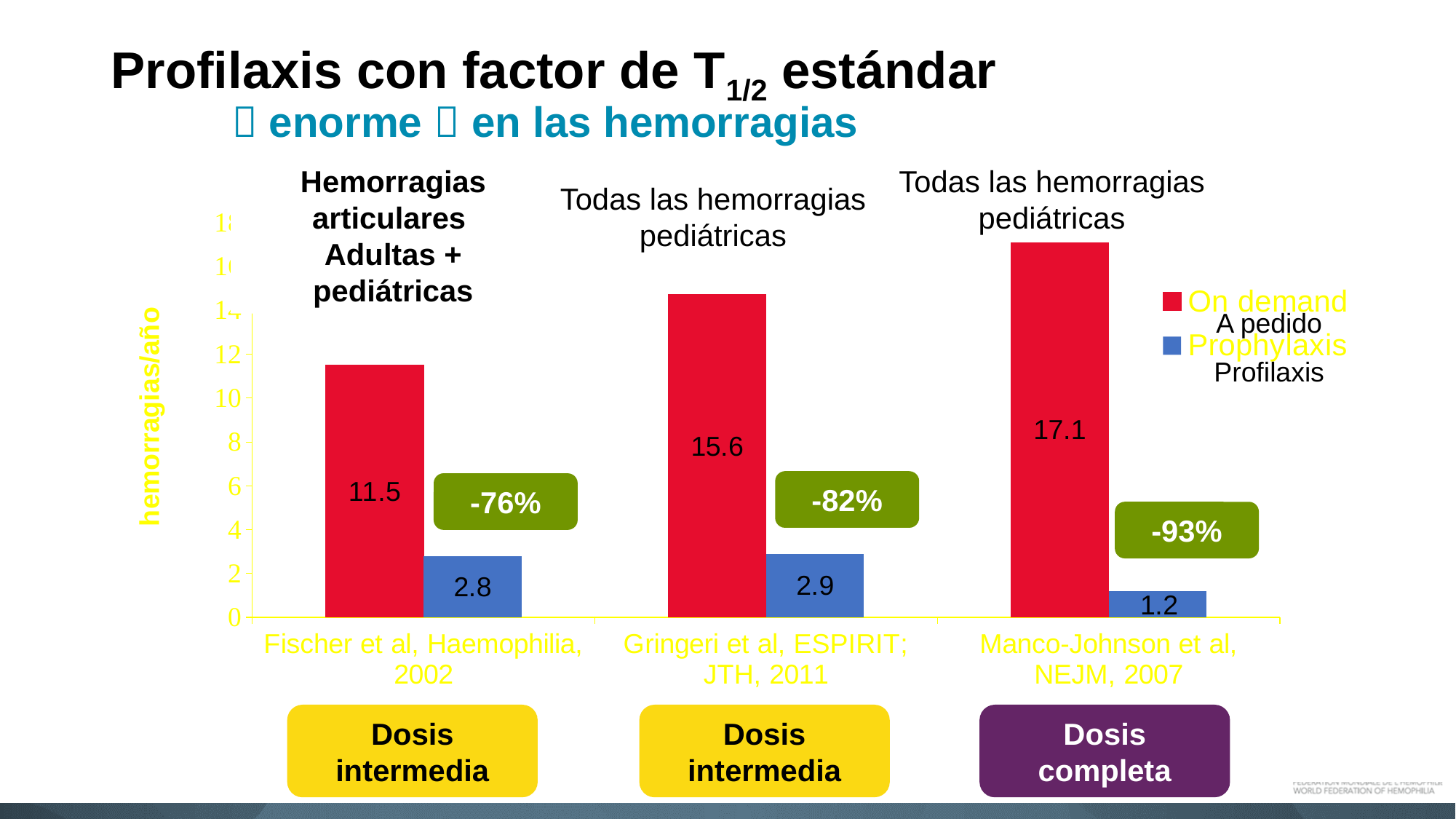
Which study has the lowest Prophylaxis value? Manco-Johnson et al, NEJM, 2007 What is the difference between the On demand and Prophylaxis values for Manco-Johnson et al, NEJM, 2007? 15.9 What is the Prophylaxis value for Manco-Johnson et al, NEJM, 2007? 1.2 What is the label of the y axis? hemorragias/año How many series does the legend list? 2 Which is larger: the On demand value for Fischer et al, Haemophilia, 2002 or the On demand value for Gringeri et al, ESPIRIT; JTH, 2011? Gringeri et al, ESPIRIT; JTH, 2011 How many studies (categories) are shown on the x axis? 3 What kind of chart is shown on the slide? Bar chart Which study has the highest On demand value? Manco-Johnson et al, NEJM, 2007 Is the On demand value for Gringeri et al, ESPIRIT; JTH, 2011 greater or less than 14? greater What is the Prophylaxis value for Gringeri et al, ESPIRIT; JTH, 2011? 2.9 What is the On demand value for Fischer et al, Haemophilia, 2002? 11.5